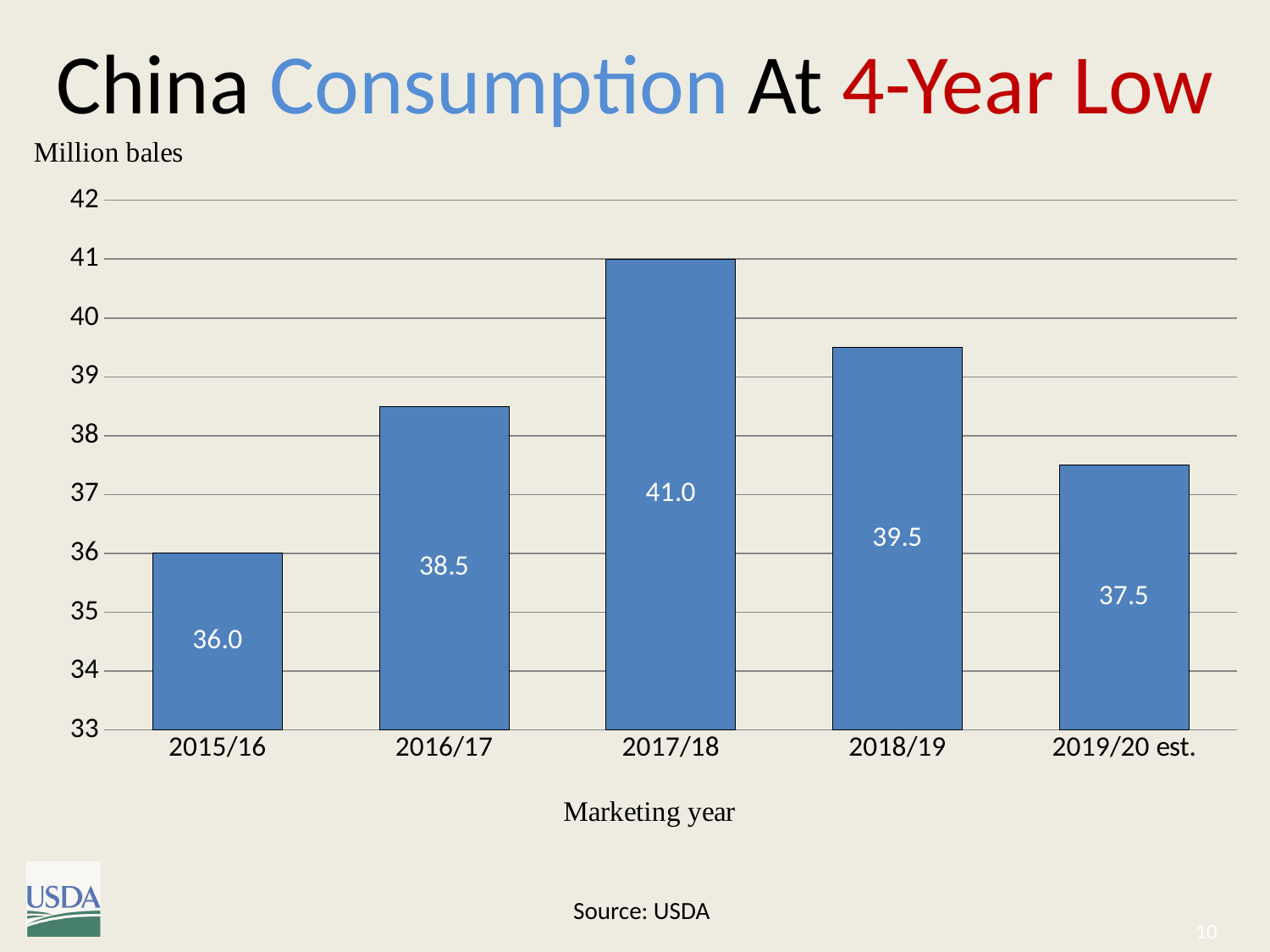
Which is larger, the value for 2018/19 or the value for 2016/17? 2018/19 What unit is shown on the vertical axis label? Million bales What is the difference between the values for 2016/17 and 2015/16? 2.5 What is the difference between the values for 2017/18 and 2019/20 est.? 3.5 What is the value for 2017/18? 41.0 Which marketing year has the highest consumption? 2017/18 Is the value for 2018/19 greater or less than 40? less What kind of chart is shown on the slide? bar chart How many marketing years are shown on the chart? 5 Which marketing year has the lowest consumption? 2015/16 What is the value for 2019/20 est.? 37.5 What is the value for 2015/16? 36.0